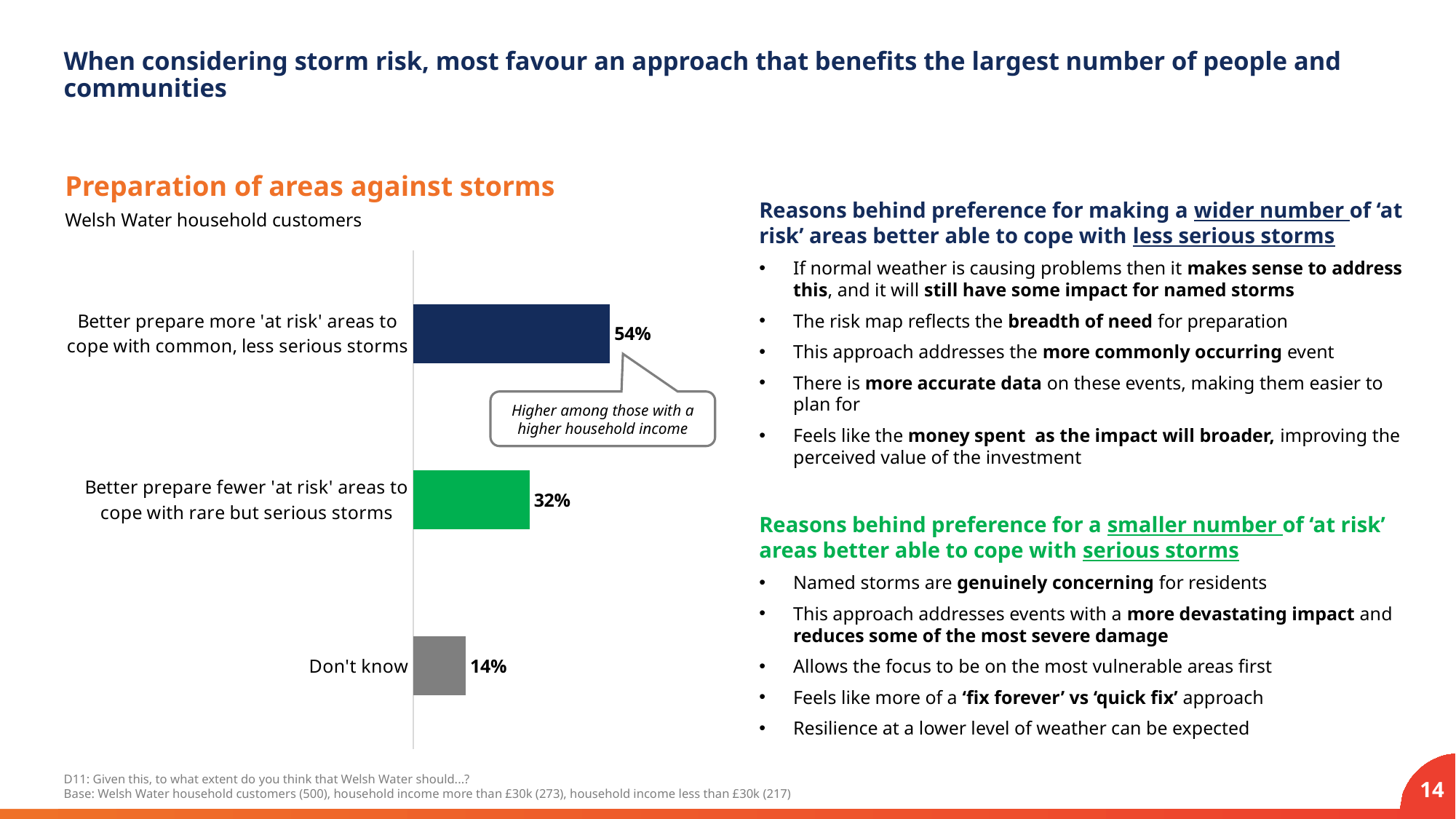
What is the title of the chart? Preparation of areas against storms Which option has the highest percentage? Better prepare more 'at risk' areas to cope with common, less serious storms According to the callout on the chart, among which group is the 54% option higher? Those with a higher household income What percentage of Welsh Water household customers chose 'Better prepare more 'at risk' areas to cope with common, less serious storms'? 54% What is the difference in percentage points between the 'more at risk areas' option and the 'fewer at risk areas' option? 22 percentage points Which is larger: the share for preparing more 'at risk' areas for less serious storms, or the share for preparing fewer 'at risk' areas for rare but serious storms? Better prepare more 'at risk' areas to cope with common, less serious storms What percentage chose 'Better prepare fewer 'at risk' areas to cope with rare but serious storms'? 32% What type of chart is used on the slide? Bar chart What percentage answered 'Don't know'? 14% What is the difference between the 'fewer at risk areas' option and 'Don't know'? 18 percentage points Which category has the lowest percentage? Don't know How many categories are shown in the chart? 3